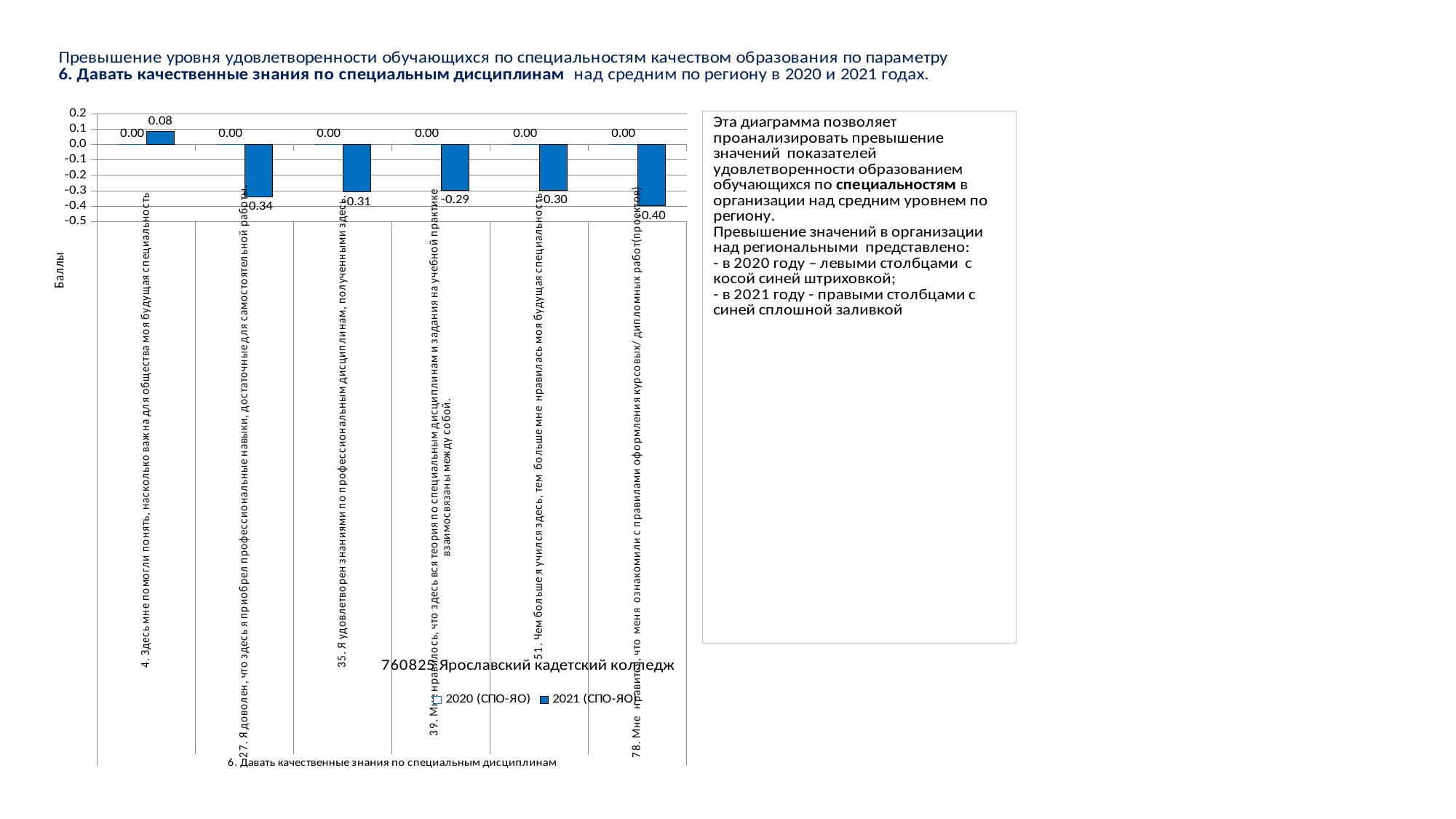
Which category has the lowest 2021 (СПО-ЯО) value? 78. Мне нравится, что меня ознакомили с правилами оформления курсовых/ дипломных работ(проектов) How many series does the chart legend list? 2 What is the 2020 (СПО-ЯО) value for category 35 (Я удовлетворен знаниями по профессиональным дисциплинам, полученными здесь)? 0.00 How many categories (questions) are plotted on the x axis of the chart? 6 What is the difference between the 2021 (СПО-ЯО) values for category 39 (-0.29) and category 78 (-0.40)? 0.11 What is the 2021 (СПО-ЯО) value for category 78 (Мне нравится, что меня ознакомили с правилами оформления курсовых/дипломных работ)? -0.40 What type of chart is shown on the slide? bar chart What is the 2021 (СПО-ЯО) value for category 27 (Я доволен, что здесь я приобрел профессиональные навыки...)? -0.34 Which category has the highest 2021 (СПО-ЯО) value? 4. Здесь мне помогли понять, насколько важна для общества моя будущая специальность Which is larger: the 2021 (СПО-ЯО) value for category 35 or for category 51? category 51 (-0.30) What is the 2021 (СПО-ЯО) value for category 4 (Здесь мне помогли понять, насколько важна для общества моя будущая специальность)? 0.08